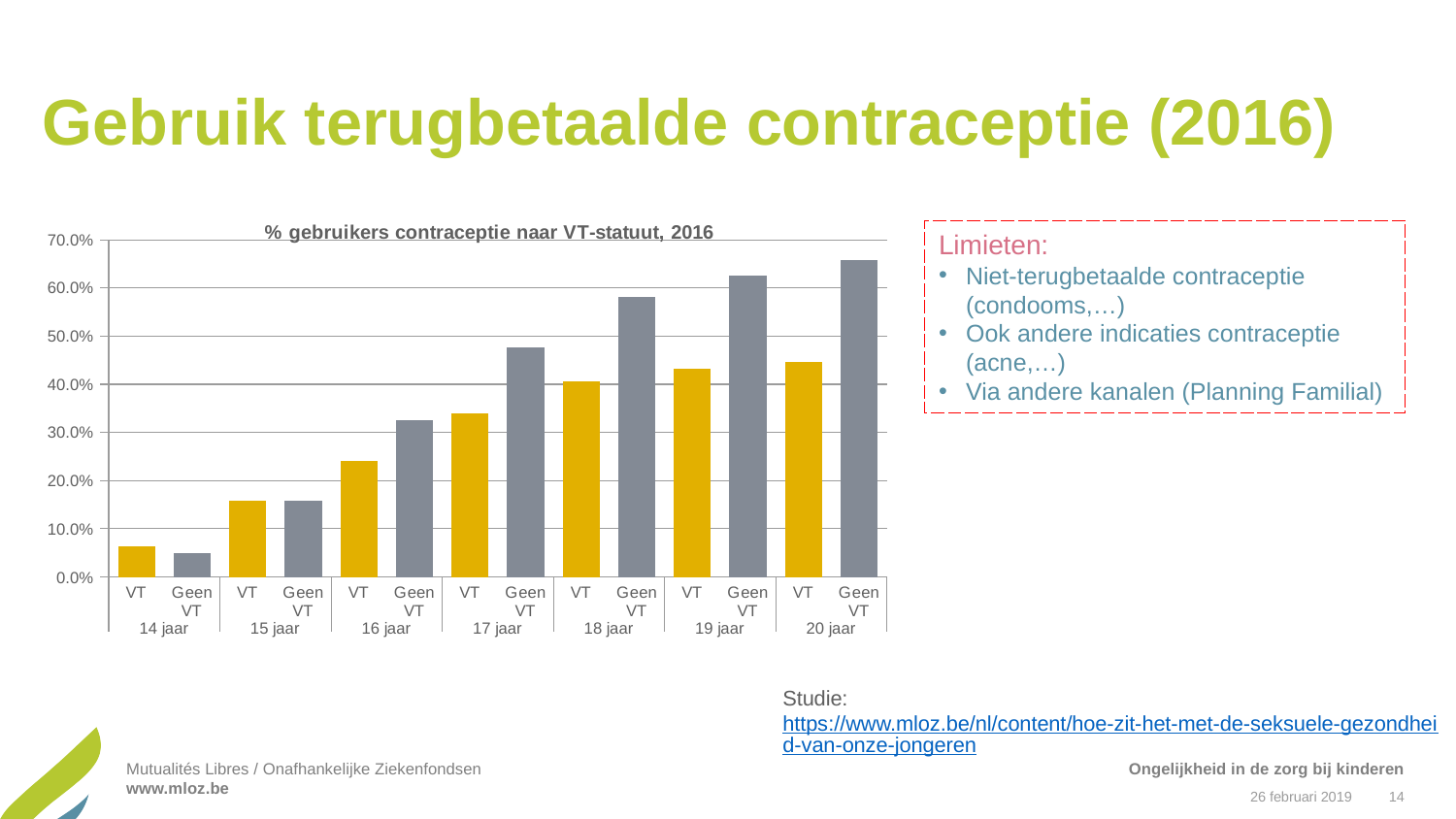
Which bar has the highest value in the chart? Geen VT, 20 jaar What is the title of the chart? % gebruikers contraceptie naar VT-statuut, 2016 What is the highest value shown on the y axis of the chart? 70.0% Is the value for VT at 16 jaar greater or less than 30.0%? less Is the value for Geen VT at 18 jaar greater or less than 50.0%? greater Is the value for VT at 14 jaar greater or less than 10.0%? less How many age groups are shown on the x axis of the chart? 7 What kind of chart is shown on the slide? bar chart At 19 jaar, which is larger: the VT bar or the Geen VT bar? Geen VT How many bars are plotted in the chart? 14 Do the Geen VT values rise or fall as age increases from 14 jaar to 20 jaar? rise